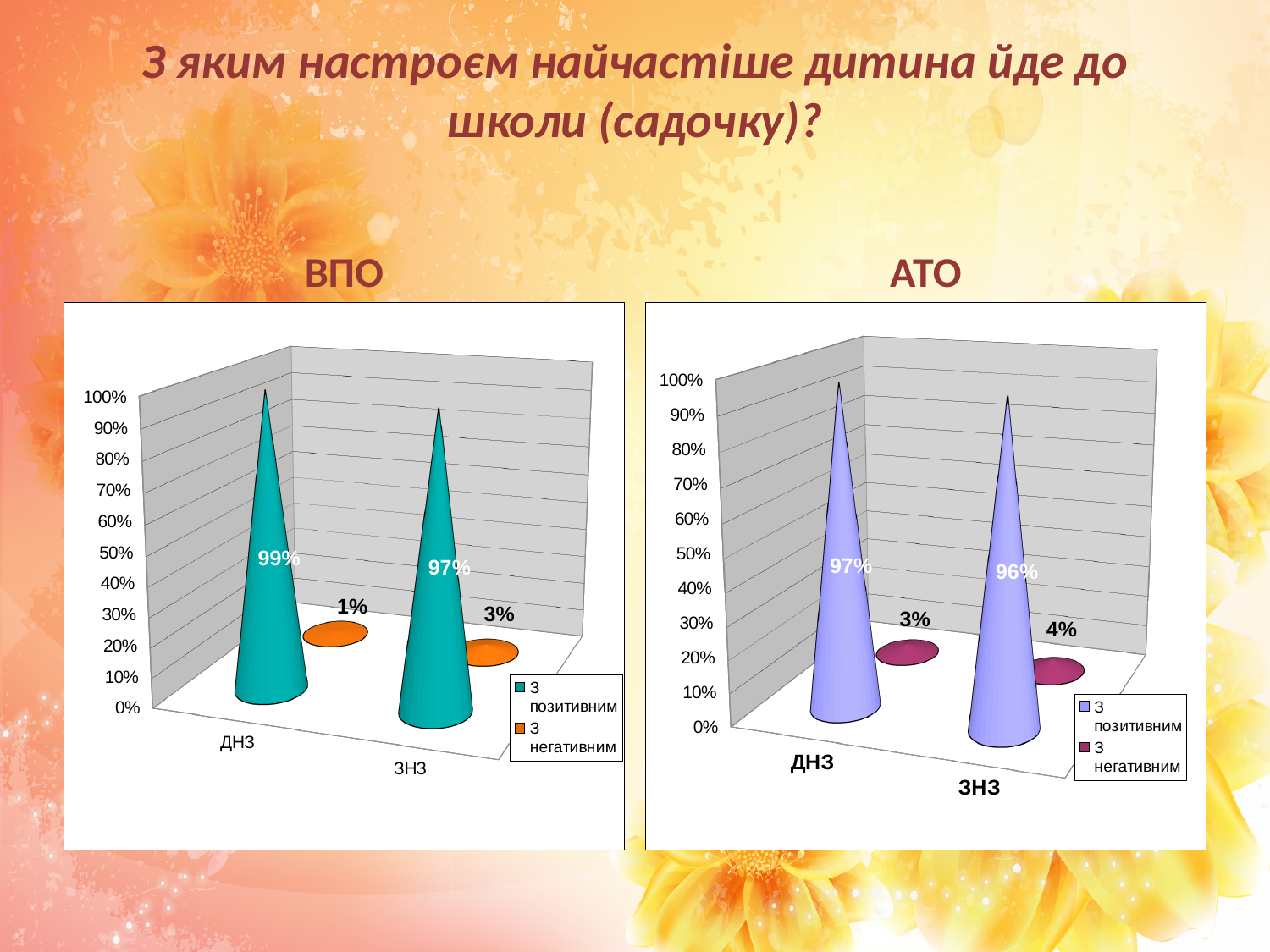
In the АТО chart, what is the value for З позитивним for ЗНЗ? 96% In the АТО chart, what is the value for З негативним for ДНЗ? 3% How many categories are shown on the x axis of the ВПО chart? 2 What kind of chart is the ВПО chart? 3D bar chart (cone-shaped bars) How many series does the legend of the АТО chart list? 2 In the ВПО chart, what is the difference between З позитивним for ДНЗ and З позитивним for ЗНЗ? 2% In the АТО chart, which category has the lower value for З позитивним? ЗНЗ Which is larger: З позитивним for ДНЗ in the ВПО chart or З позитивним for ДНЗ in the АТО chart? ВПО chart (99%) In the ВПО chart, what is the value for З негативним for ЗНЗ? 3% In the АТО chart, what is the difference between З негативним for ЗНЗ and З негативним for ДНЗ? 1% In the ВПО chart, what is the value for З позитивним for ДНЗ? 99% In the ВПО chart, which category has the higher value for З негативним? ЗНЗ